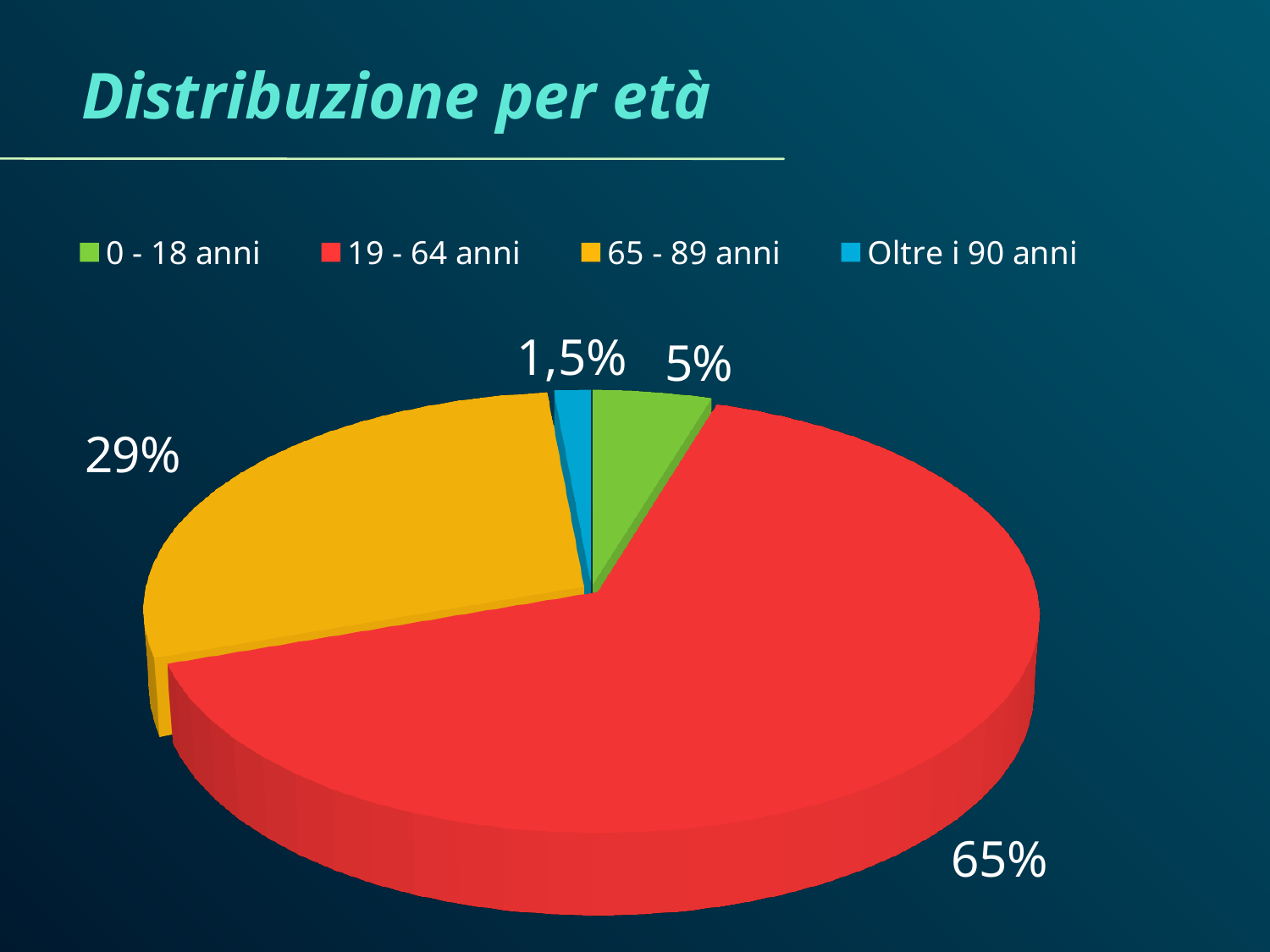
What percentage is shown for the 0 - 18 anni slice? 5% What is the title of the chart? Distribuzione per età How many categories does the legend list? 4 What percentage is shown for the Oltre i 90 anni slice? 1,5% What is the difference in percentage points between the 19 - 64 anni slice and the 65 - 89 anni slice? 36 What percentage is shown for the 65 - 89 anni slice? 29% Which age group has the largest share of the pie? 19 - 64 anni Which slice is larger, 65 - 89 anni or 0 - 18 anni? 65 - 89 anni What type of chart is shown on the slide? pie chart What percentage is shown for the 19 - 64 anni slice? 65% What colour is the slice for 65 - 89 anni? yellow Which age group has the smallest share of the pie? Oltre i 90 anni